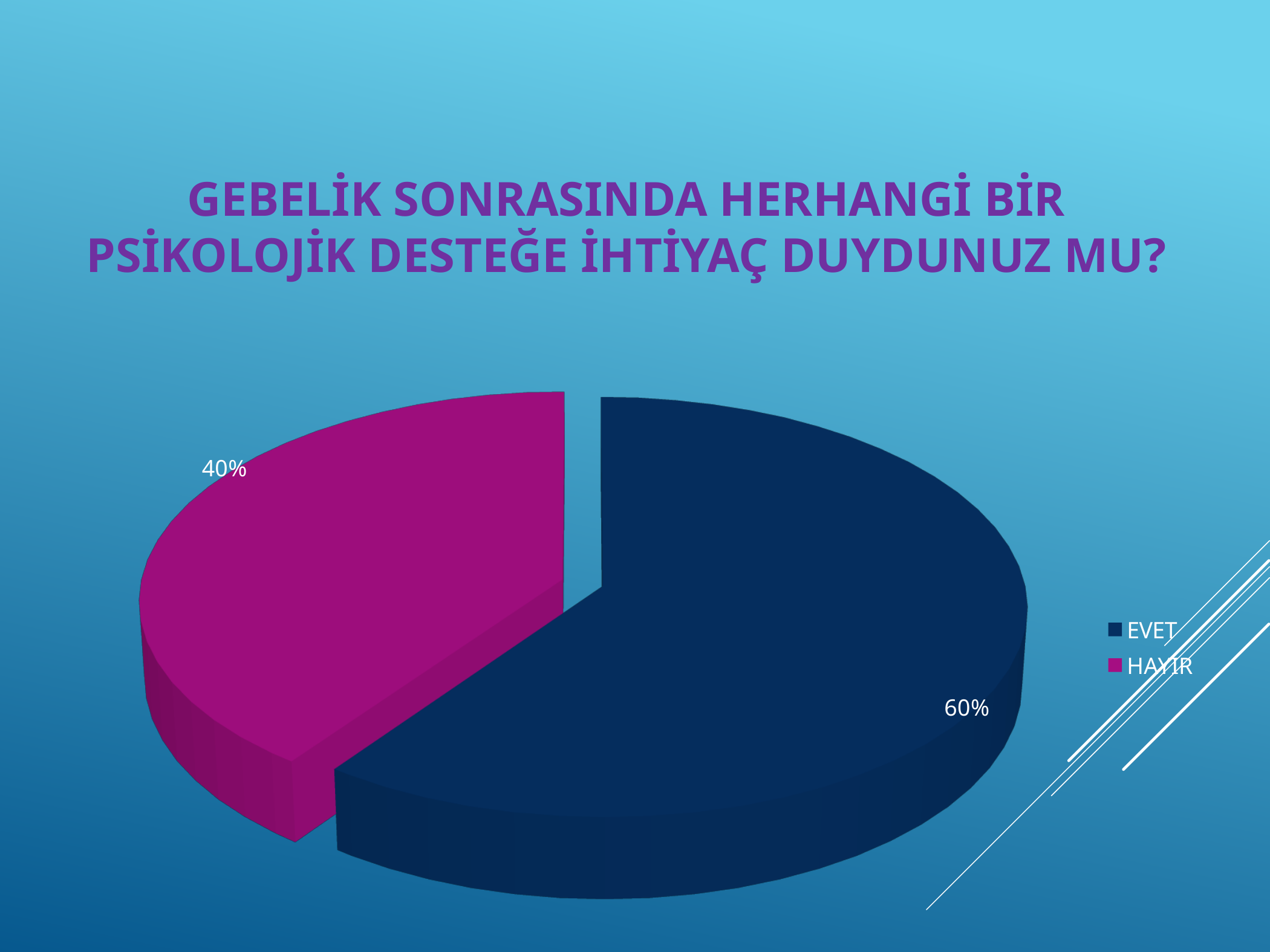
What share of the pie does the HAYIR slice represent? 40% What is the difference in percentage points between the EVET and HAYIR slices? 20 How many slices does the pie chart have? 2 How many entries does the legend list? 2 What percentage of the pie is labelled EVET? 60% What is the title of the chart? GEBELİK SONRASINDA HERHANGİ BİR PSİKOLOJİK DESTEĞE İHTİYAÇ DUYDUNUZ MU? Which category has the largest share of the pie? EVET Which category has the smallest share of the pie? HAYIR What colour is the EVET slice? Dark blue What percentage of the pie is labelled HAYIR? 40% Which slice is larger, EVET or HAYIR? EVET What kind of chart is shown on the slide? Pie chart